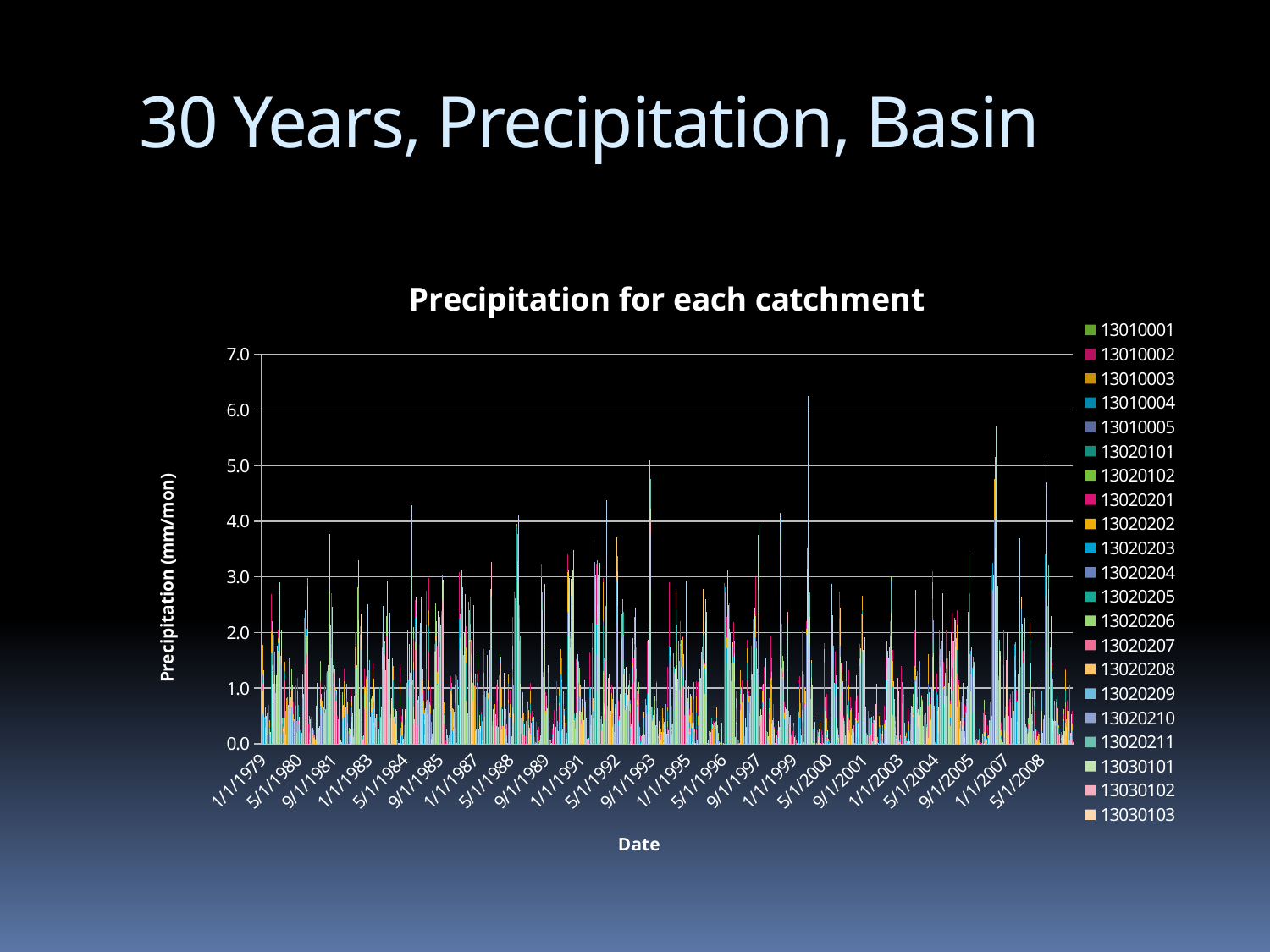
Is the highest value plotted on the chart greater or less than 7.0? less Is the tallest spike on the chart, near 1999, greater or less than 6.0? greater What is the title of the chart? Precipitation for each catchment Is the tallest spike near 2007 greater or less than 5.0? greater What kind of chart is shown on the slide? bar chart What is the label of the vertical axis? Precipitation (mm/mon) How many series does the legend list? 21